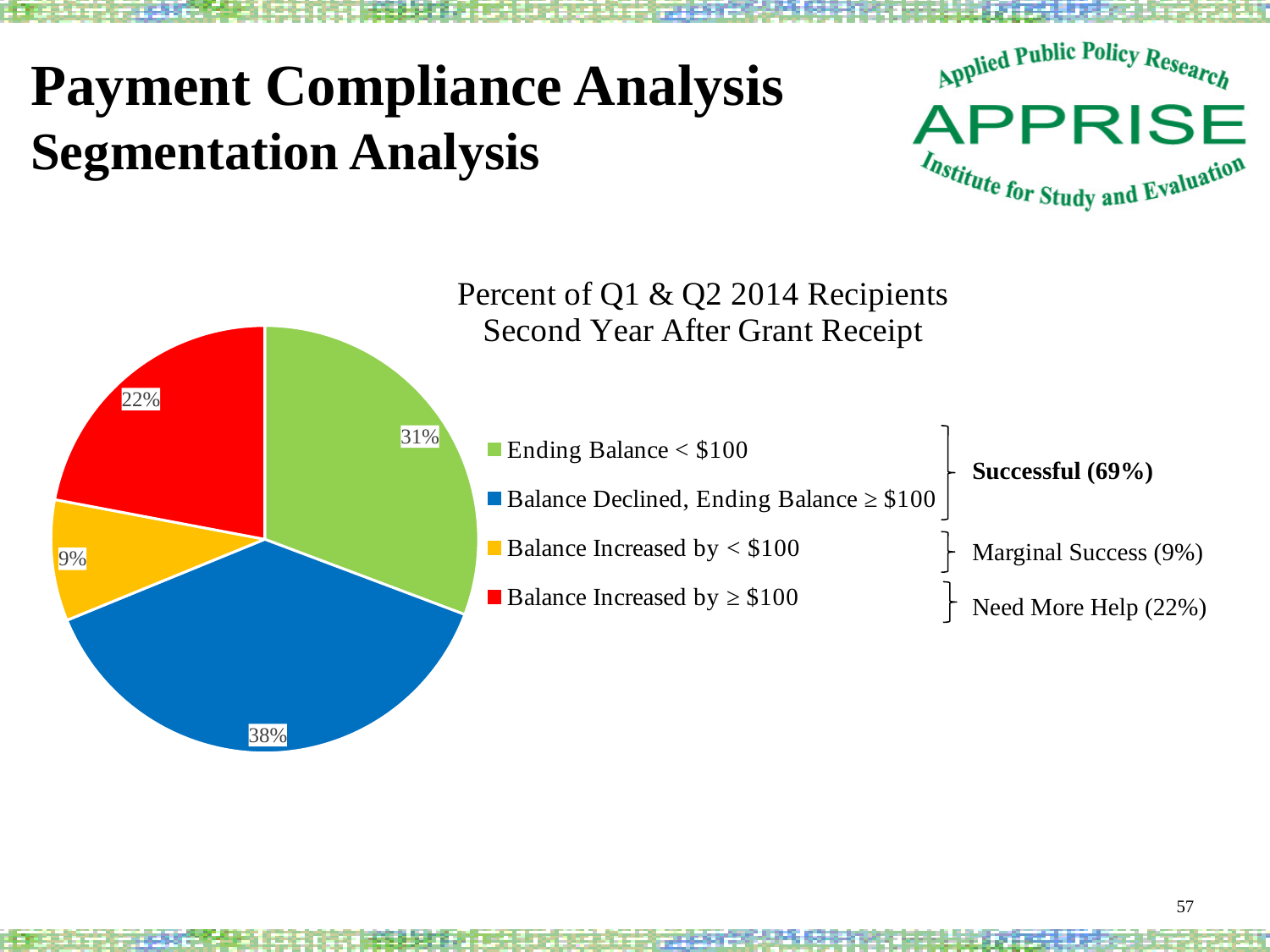
What is the difference between the share for Balance Declined, Ending Balance ≥ $100 and the share for Ending Balance < $100? 7% What percentage of recipients had Balance Declined, Ending Balance ≥ $100? 38% What is the title of the pie chart? Percent of Q1 & Q2 2014 Recipients Second Year After Grant Receipt Which is larger: the share for Balance Increased by ≥ $100 or the share for Balance Increased by < $100? Balance Increased by ≥ $100 How many categories does the pie chart have? 4 What type of chart is shown on the slide? pie chart What percentage of recipients had Balance Increased by < $100? 9% What percentage of recipients had an Ending Balance < $100? 31% What colour is the slice for Balance Increased by ≥ $100? red Which category has the largest share of the pie? Balance Declined, Ending Balance ≥ $100 What percentage of recipients had Balance Increased by ≥ $100? 22% Which category has the smallest share of the pie? Balance Increased by < $100